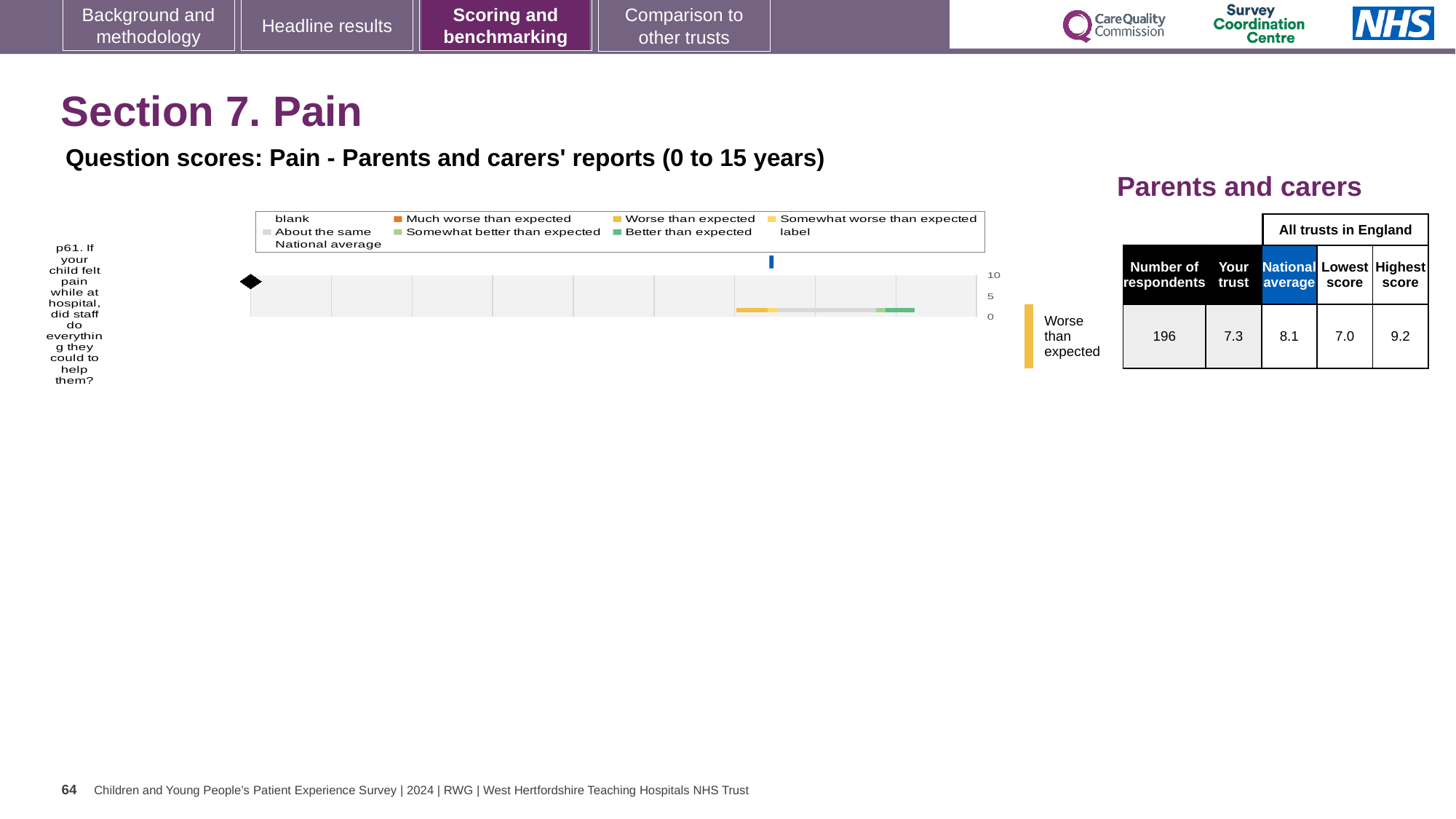
Which benchmark rating is shown beside the chart for question p61? Worse than expected What colour does the legend use for 'Better than expected'? green What kind of chart is shown on the slide? bar chart How many question categories are plotted on the chart? 1 How many entries does the chart's legend list? 9 What is the highest tick value shown on the chart's score axis? 10